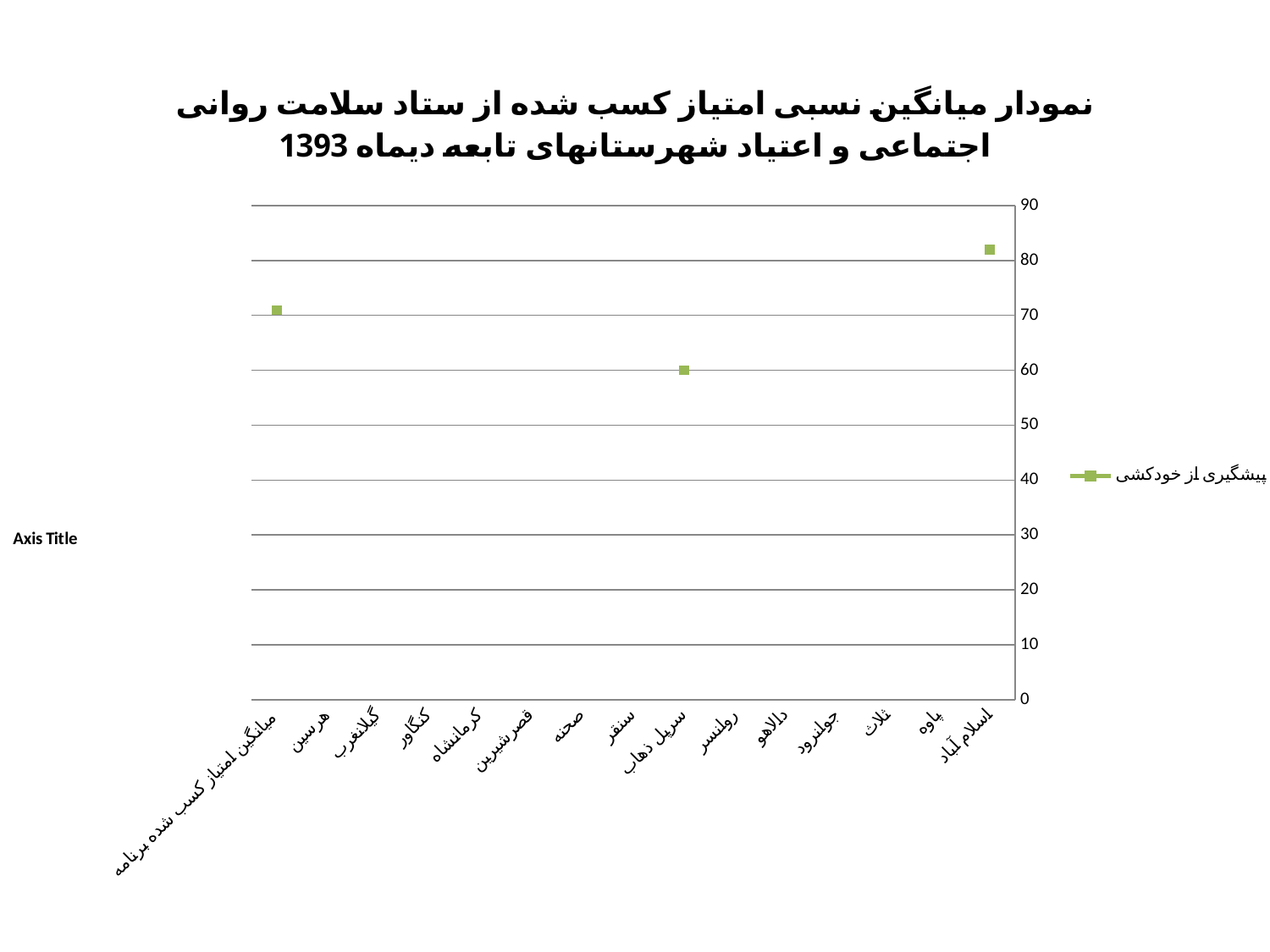
Is the value for میانگین امتیاز کسب شده برنامه greater or less than 60? greater Which of the plotted categories has the lowest value? سرپل ذهاب What is the highest tick value shown on the vertical axis? 90 Is the value for میانگین امتیاز کسب شده برنامه greater or less than 80? less Which category has the highest plotted value? اسلام آباد Which is larger, the value for میانگین امتیاز کسب شده برنامه or the value for سرپل ذهاب? میانگین امتیاز کسب شده برنامه What is the name of the series shown in the legend? پیشگیری از خودکشی Which is larger, the value for اسلام آباد or the value for سرپل ذهاب? اسلام آباد How many categories are labelled on the x axis? 15 Is the value for اسلام آباد greater or less than 80? greater How many series does the legend list? 1 What is the value for سرپل ذهاب? 60